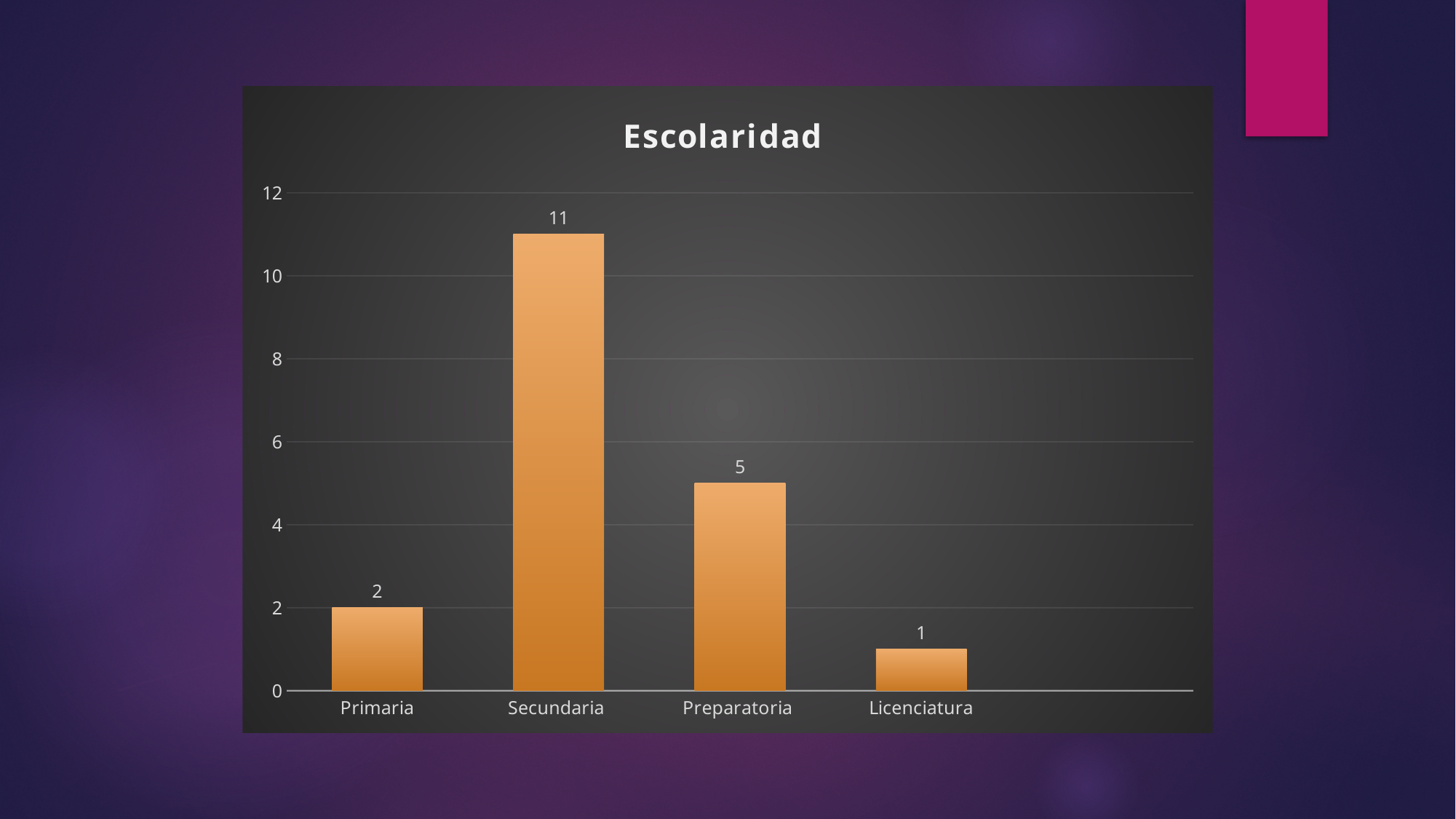
What is the value for Preparatoria? 5 Which is larger, the value for Primaria or the value for Preparatoria? Preparatoria What is the value for Licenciatura? 1 Which category has the lowest value? Licenciatura What is the value for Secundaria? 11 Is the value for Secundaria greater or less than 10? greater What is the title of the chart? Escolaridad What kind of chart is shown on the slide? Bar chart What is the difference between the values for Secundaria and Preparatoria? 6 What is the value for Primaria? 2 How many categories are shown on the x axis? 4 Which category has the highest value? Secundaria